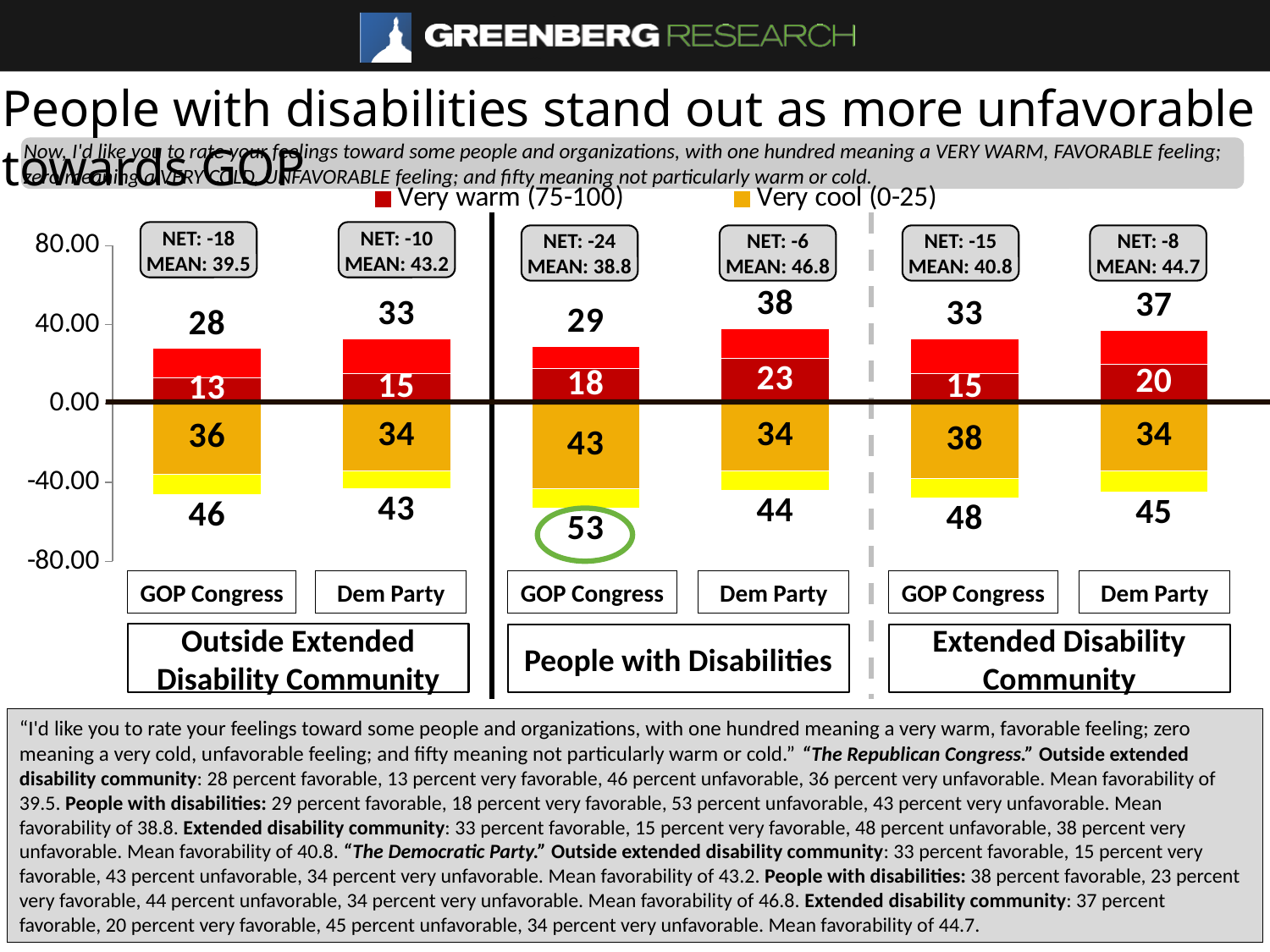
Which is larger: the very warm value for Dem Party in the Extended Disability Community or for Dem Party Outside the Extended Disability Community? Dem Party in the Extended Disability Community How many series does the legend list? 2 Which bar has the lowest very warm (75-100) value? GOP Congress, Outside Extended Disability Community How many bars are plotted in the chart? 6 Which bar has the highest total unfavorable value? GOP Congress, People with Disabilities What is the total warm (favorable) value shown above the bar for GOP Congress among People with Disabilities? 29 What is the total unfavorable value shown below the bar for GOP Congress in the Extended Disability Community? 48 What is the MEAN shown for Dem Party among People with Disabilities? 46.8 What is the very cool (0-25) value for GOP Congress among People with Disabilities? 43 What is the very warm (75-100) value for Dem Party among People with Disabilities? 23 What is the difference between the very cool values for GOP Congress and Dem Party among People with Disabilities? 9 What is the NET shown for GOP Congress among People with Disabilities? -24